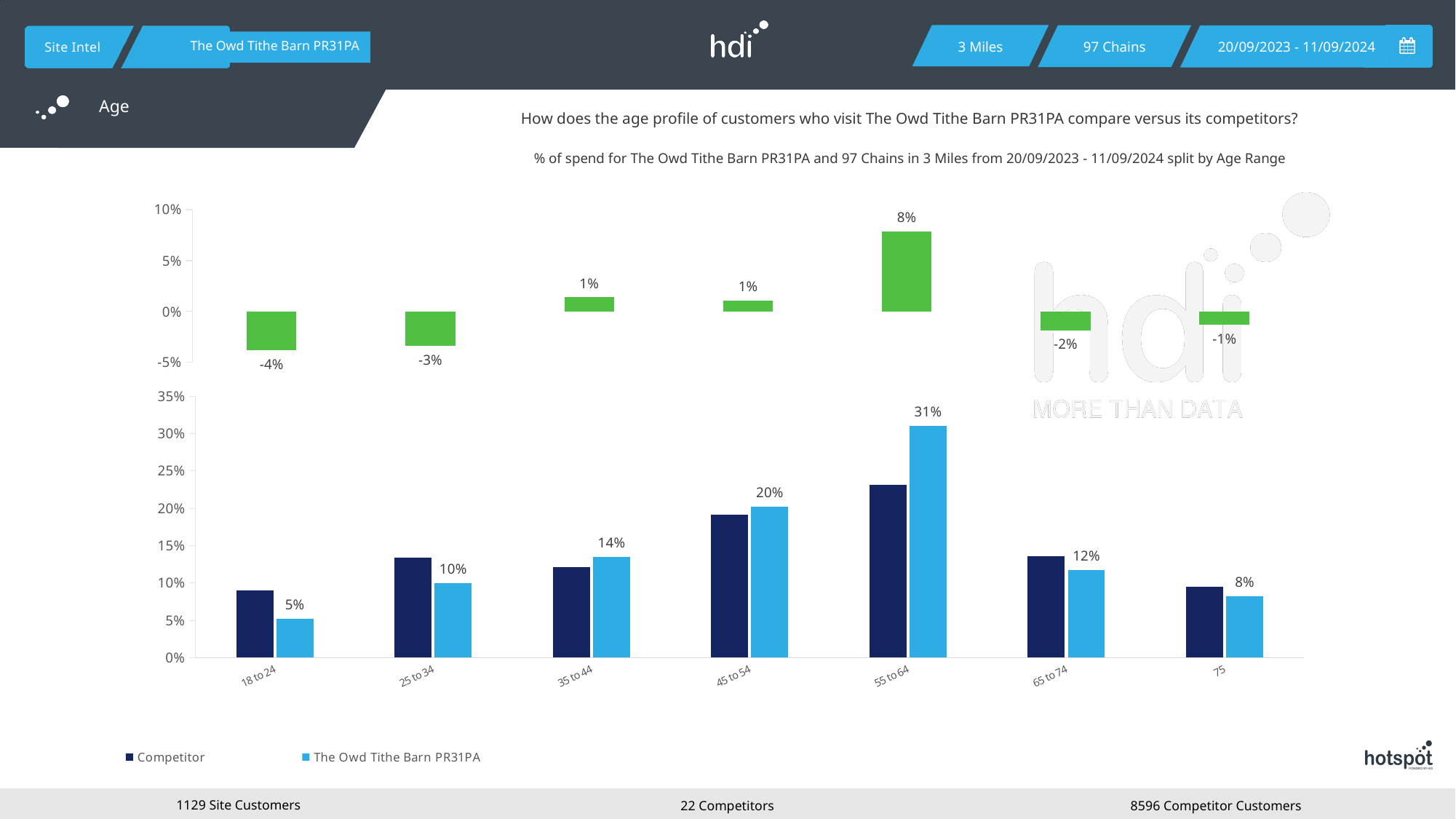
What kind of chart is the bottom chart? Bar chart In the top chart, which age range has the lowest value? 18 to 24 In the bottom chart, what is the value for The Owd Tithe Barn PR31PA in the 55 to 64 age range? 31% In the bottom chart, for the 18 to 24 age range, which is larger: the Competitor bar or The Owd Tithe Barn PR31PA bar? Competitor How many age ranges are shown on the x axis of the bottom chart? 7 In the top chart, what is the value shown for the 18 to 24 age range? -4% How many series does the legend of the bottom chart list? 2 In the bottom chart, what is the difference between The Owd Tithe Barn PR31PA values for 55 to 64 and 45 to 54? 11% In the bottom chart, what is the value for The Owd Tithe Barn PR31PA in the 18 to 24 age range? 5% In the top chart, what is the value shown for the 55 to 64 age range? 8% In the bottom chart, is the Competitor value for 55 to 64 greater or less than 20%? greater In the bottom chart, which age range has the highest value for The Owd Tithe Barn PR31PA? 55 to 64